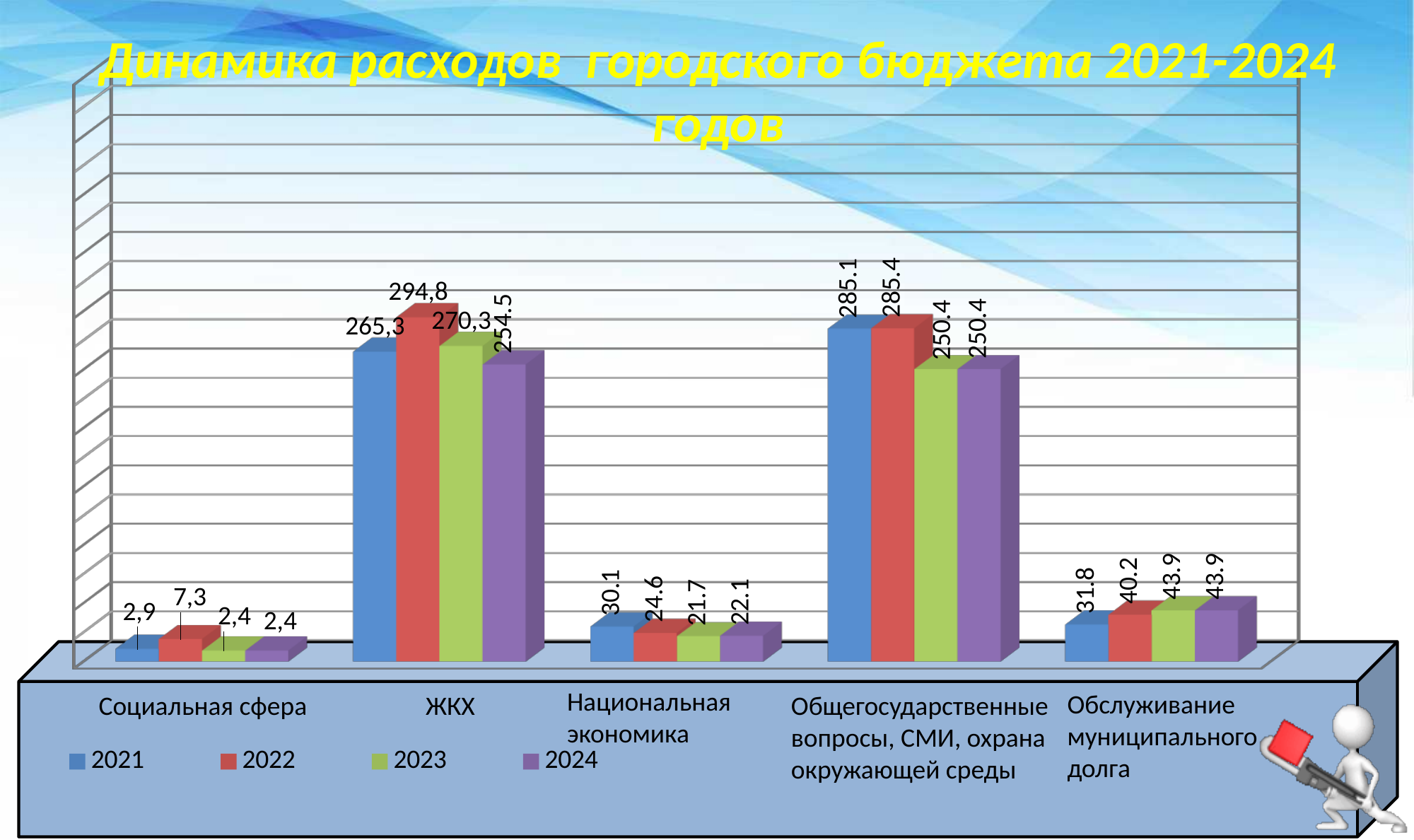
What is the value for Обслуживание муниципального долга in 2024? 43.9 Do the values for Обслуживание муниципального долга rise or fall from 2021 to 2023? rise What is the difference between the 2022 and 2021 values for Обслуживание муниципального долга? 8.4 How many series does the legend list? 4 What is the difference between the 2022 and 2021 values for ЖКХ? 29,5 Which year has the highest value for ЖКХ? 2022 What kind of chart is shown on the slide? bar chart What is the value for Национальная экономика in 2021? 30.1 How many categories are shown on the x axis? 5 Which is larger in 2021: Национальная экономика or Обслуживание муниципального долга? Обслуживание муниципального долга What is the value for ЖКХ in 2022? 294,8 Which category has the lowest value in 2021? Социальная сфера